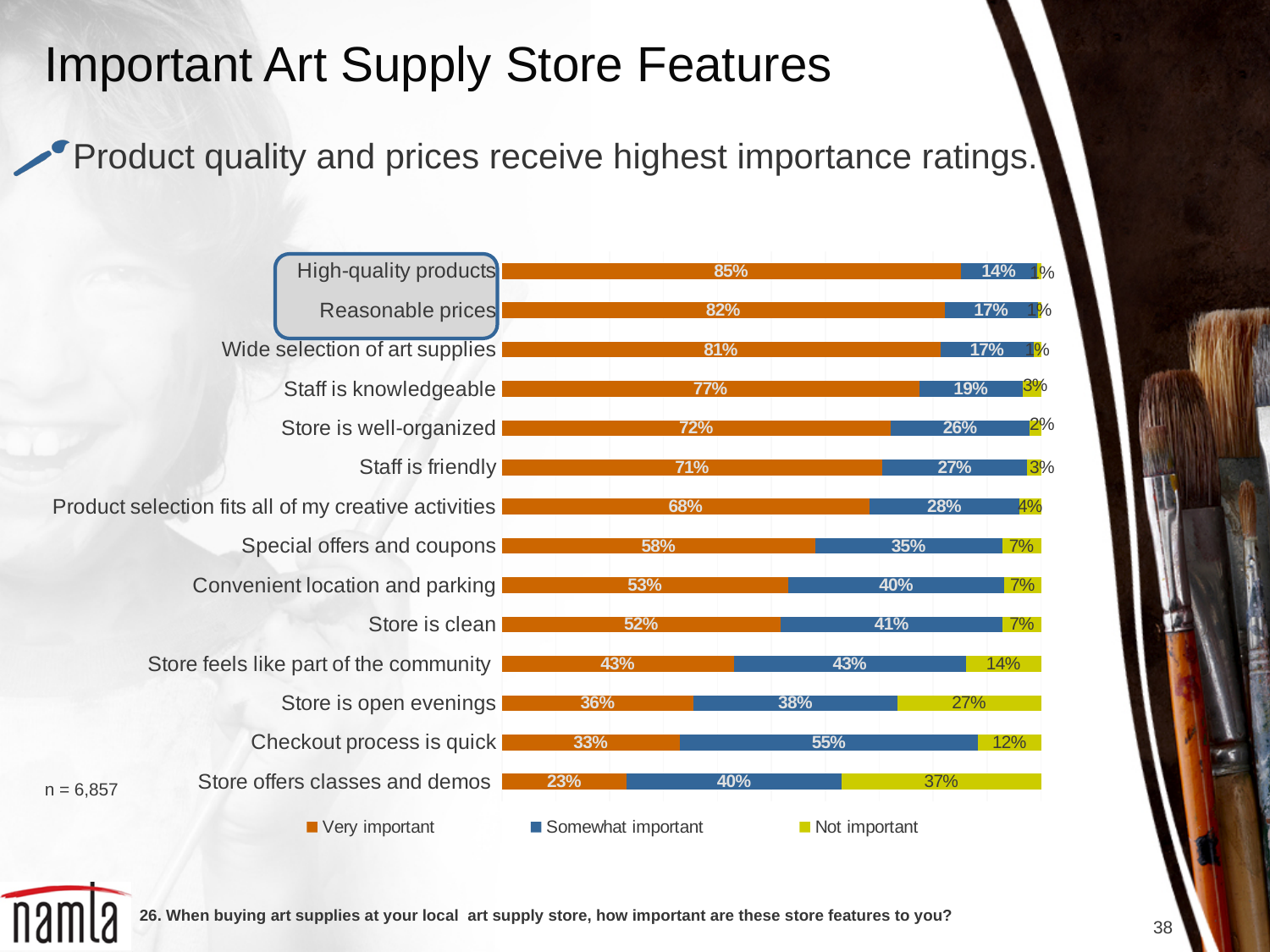
What percentage rated 'High-quality products' as very important? 85% Which store feature has the highest 'Very important' percentage? High-quality products How many store features are shown in the chart? 14 What is the 'Very important' value for 'Store feels like part of the community'? 43% What type of chart is shown on the slide? Stacked bar chart What percentage rated 'Store offers classes and demos' as not important? 37% How many series does the legend list? 3 What is the 'Somewhat important' value for 'Checkout process is quick'? 55% What is the sample size (n) shown on the slide? 6,857 Which store feature has the lowest 'Very important' percentage? Store offers classes and demos What is the difference between the 'Very important' percentages for 'Reasonable prices' and 'Store is clean'? 30% Which has a higher 'Not important' percentage: 'Store is open evenings' or 'Checkout process is quick'? Store is open evenings